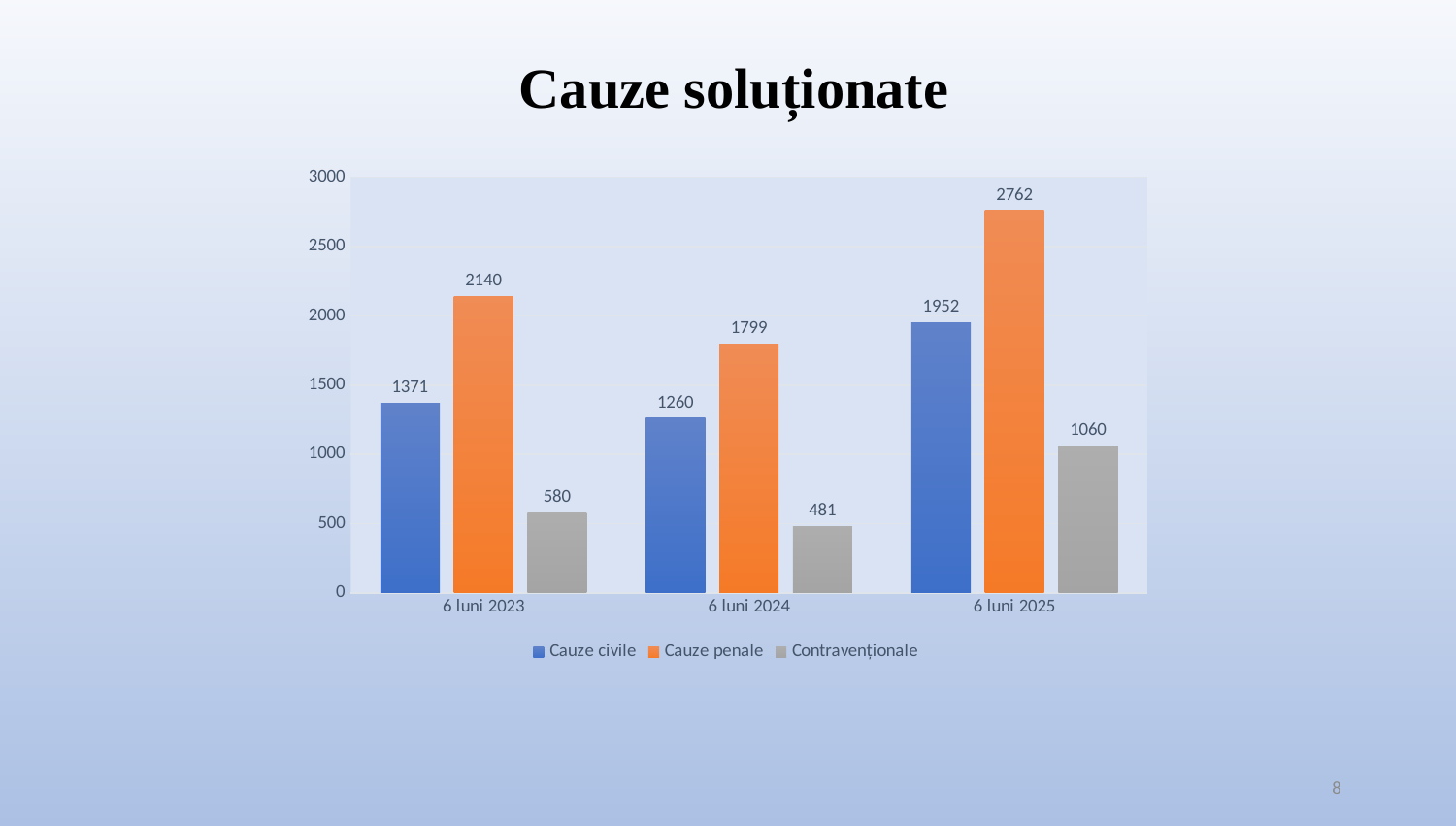
What is the value for Contravenționale in 6 luni 2024? 481 What is the value for Cauze penale in 6 luni 2025? 2762 In which period is the value for Cauze penale highest? 6 luni 2025 How many periods are shown on the x axis? 3 What is the value for Cauze civile in 6 luni 2023? 1371 What is the title of the chart? Cauze soluționate How many series does the legend list? 3 What kind of chart is shown on the slide? bar chart Which is larger in 6 luni 2024: Cauze civile or Cauze penale? Cauze penale Is the value for Cauze civile in 6 luni 2025 greater or less than 1500? greater What is the difference between Cauze penale and Cauze civile in 6 luni 2025? 810 In which period is the value for Contravenționale lowest? 6 luni 2024